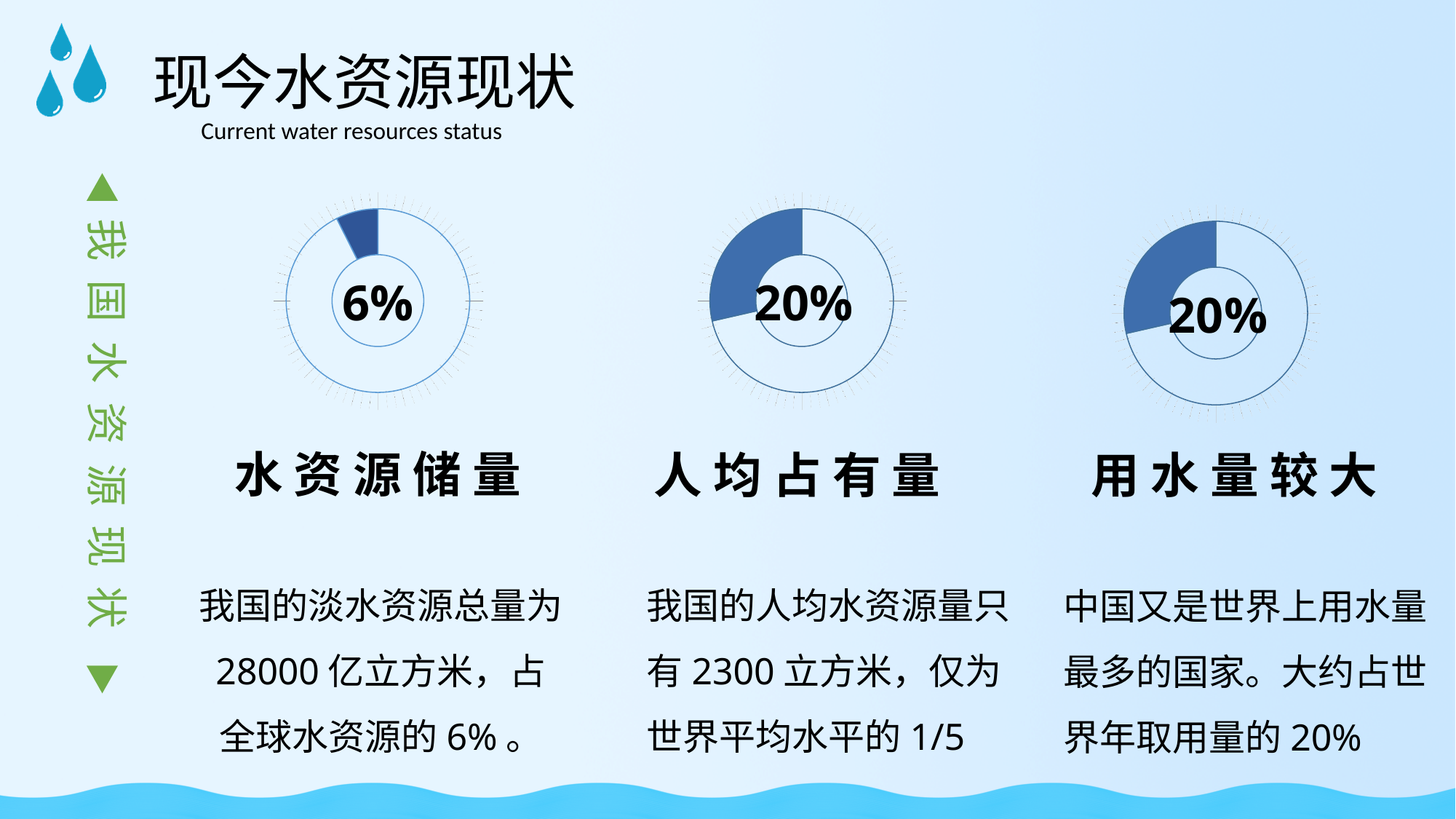
Which of the three charts shows the smallest percentage? 水资源储量 What is the title of the slide containing the three ring charts? 现今水资源现状 What percentage is shown in the 用水量较大 chart? 20% What percentage is shown in the 水资源储量 chart? 6% What colour is the filled segment in each ring chart? Dark blue Which is larger, the percentage in the 水资源储量 chart or the percentage in the 人均占有量 chart? 人均占有量 What kind of chart is used for the 水资源储量 figure? Donut (ring) chart What percentage is shown in the 人均占有量 chart? 20% Do the 人均占有量 and 用水量较大 charts show the same percentage? Yes, both 20% How many ring charts are on the slide? 3 What is the difference between the percentage in the 人均占有量 chart and the percentage in the 水资源储量 chart? 14 percentage points